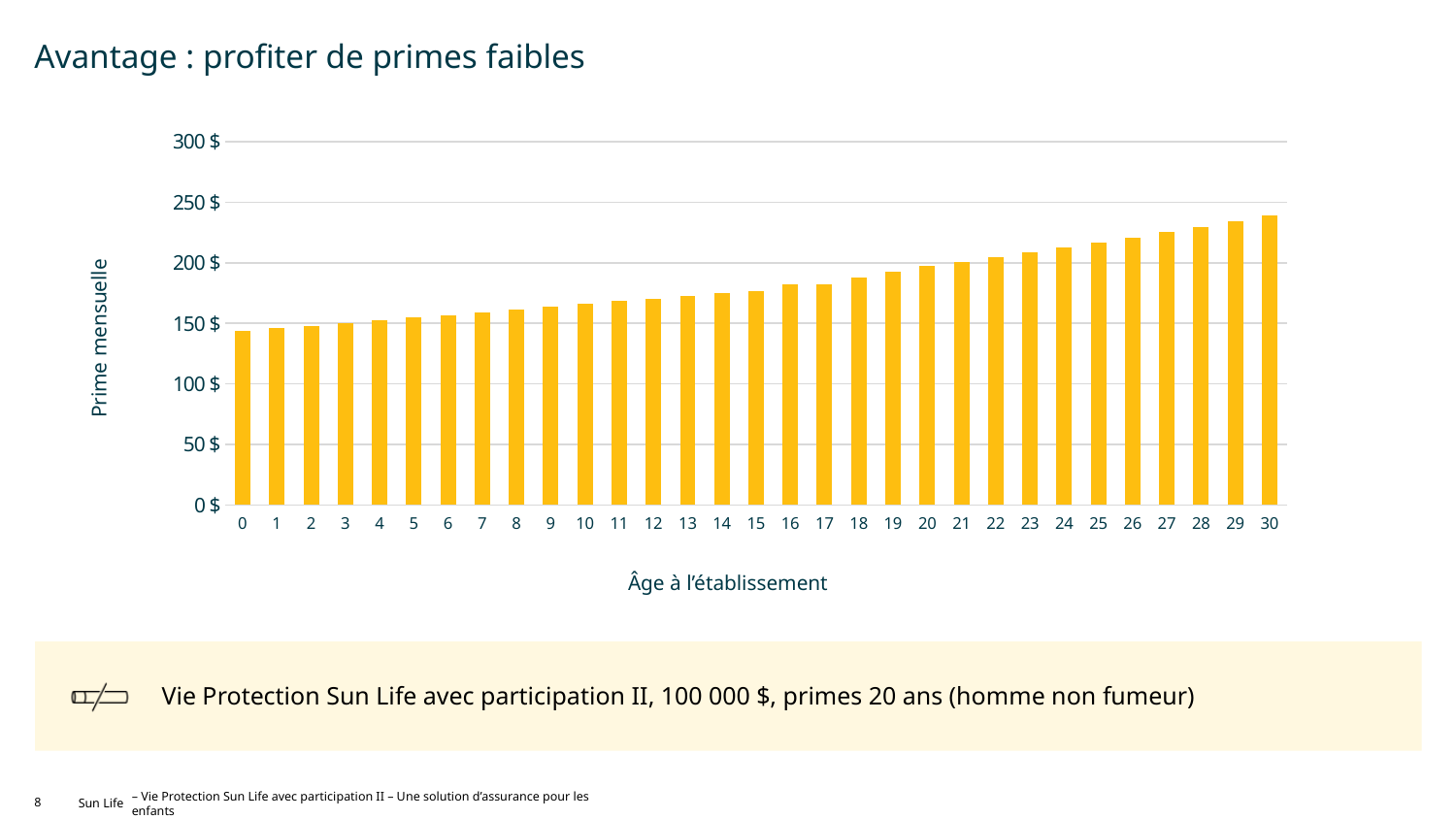
Which age at issue has the lowest monthly premium? 0 Is the monthly premium for age 30 greater or less than 200 $? greater Do the monthly premiums rise or fall as the age at issue increases? Rise How many ages (categories) are plotted along the x axis? 31 Which has the larger monthly premium, age 10 or age 25? Age 25 What is the label of the vertical axis? Prime mensuelle Is the monthly premium for age 0 greater or less than 150 $? less Is the monthly premium for age 5 greater or less than 200 $? less What kind of chart is shown on the slide? Bar chart Which age at issue has the highest monthly premium? 30